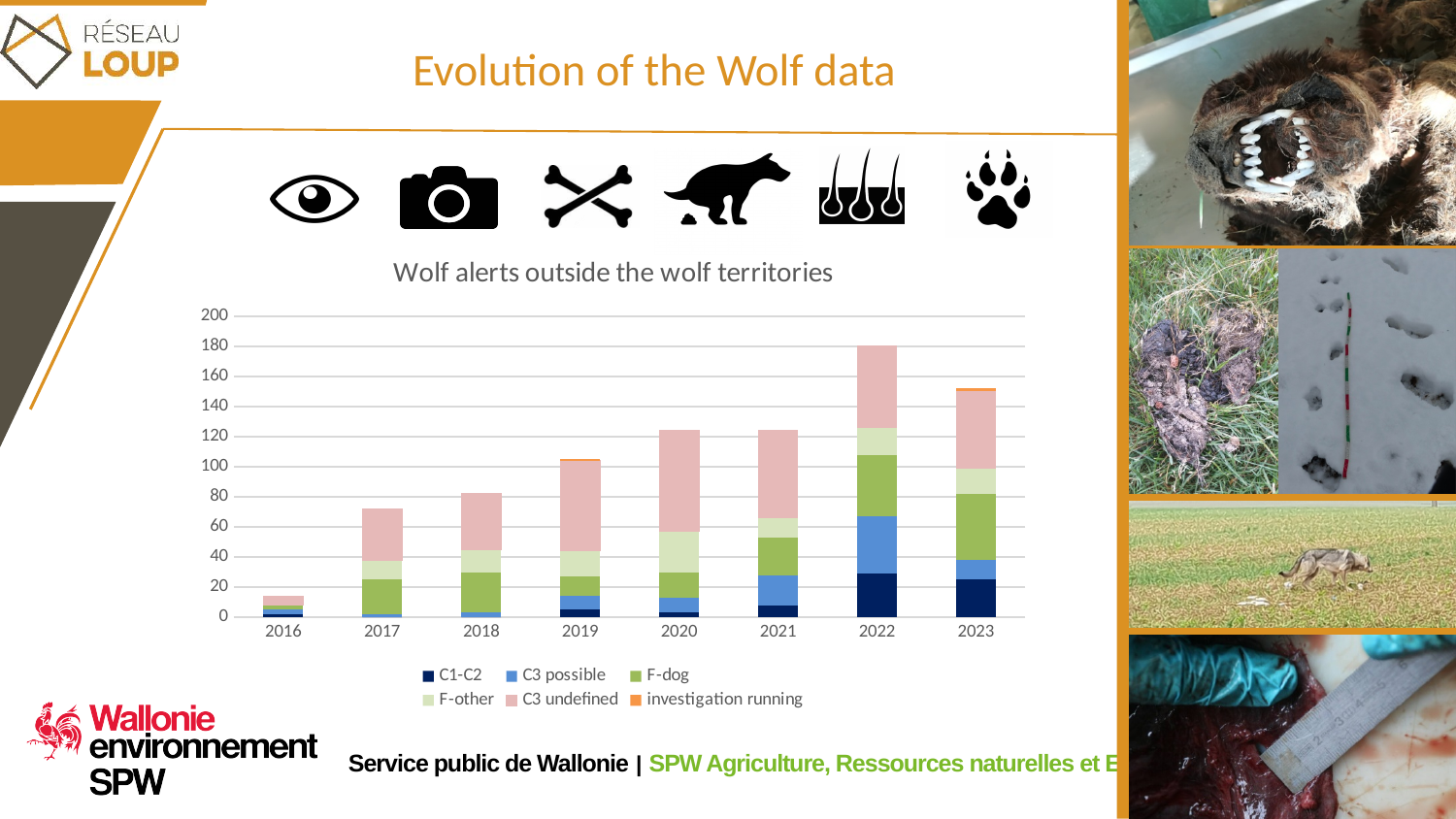
How many series does the chart's legend list? 6 What is the title of the chart? Wolf alerts outside the wolf territories How many years are shown on the x axis of the chart? 8 Do the total bars generally rise or fall from 2016 to 2022? rise Is the total bar for 2023 greater or less than 140? greater Is the total bar for 2022 greater or less than 160? greater Is the total bar for 2016 greater or less than 20? less What kind of chart is shown on the slide? Stacked bar chart Which year has the lowest total bar in the chart? 2016 Which year has a larger total bar, 2022 or 2023? 2022 Which year has the highest total bar in the chart? 2022